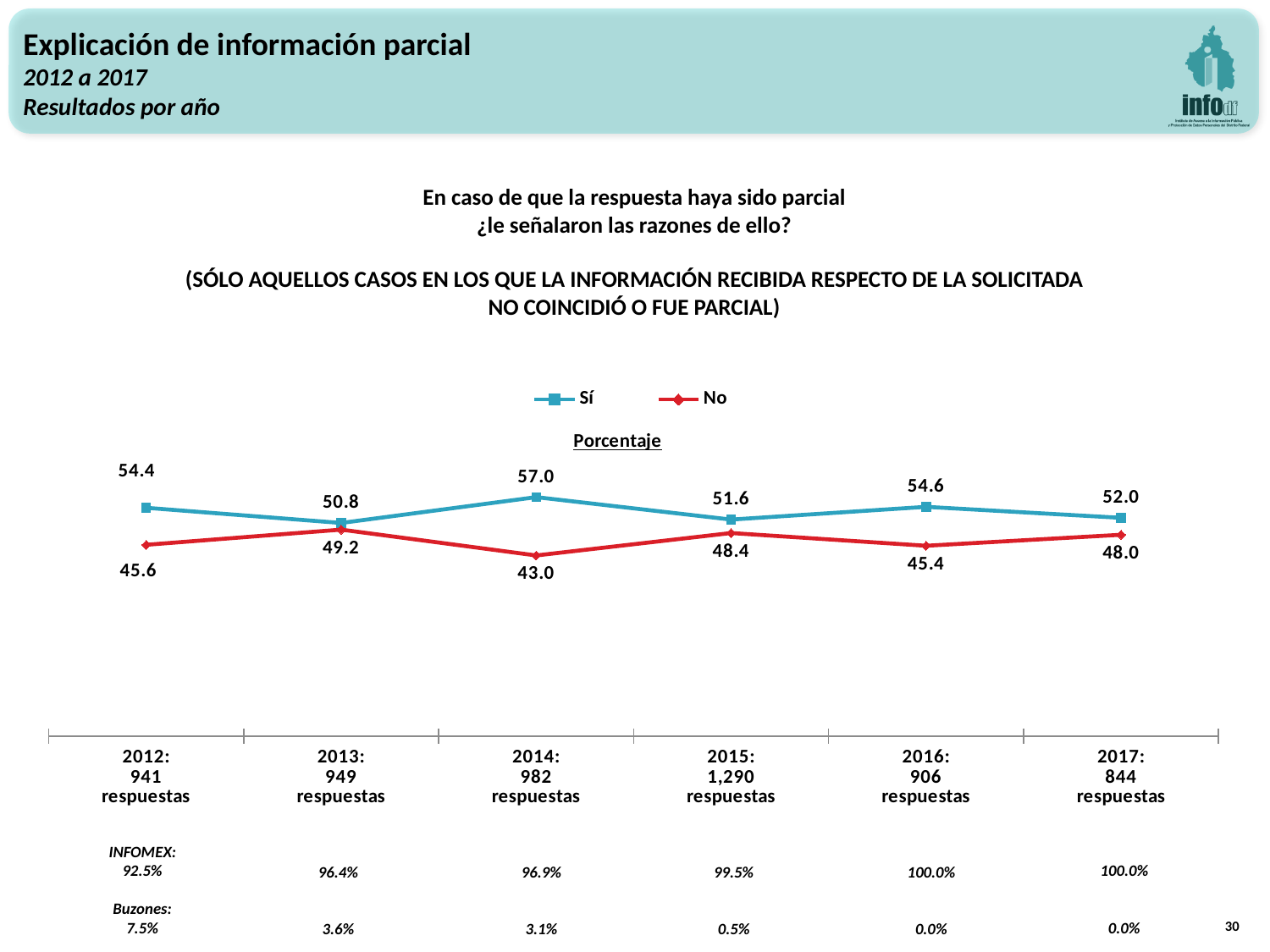
In which year is the Sí series highest? 2014 Which is larger in 2017, Sí or No? Sí What is the difference between Sí and No in 2014? 14.0 What is the value for Sí in 2012? 54.4 Which series is drawn in red? No What is the value for Sí in 2014? 57.0 How many series does the legend list? 2 What is the value for No in 2016? 45.4 What is the difference between Sí and No in 2013? 1.6 How many years are plotted on the x axis? 6 In which year is the No series lowest? 2014 What kind of chart is shown? Line chart